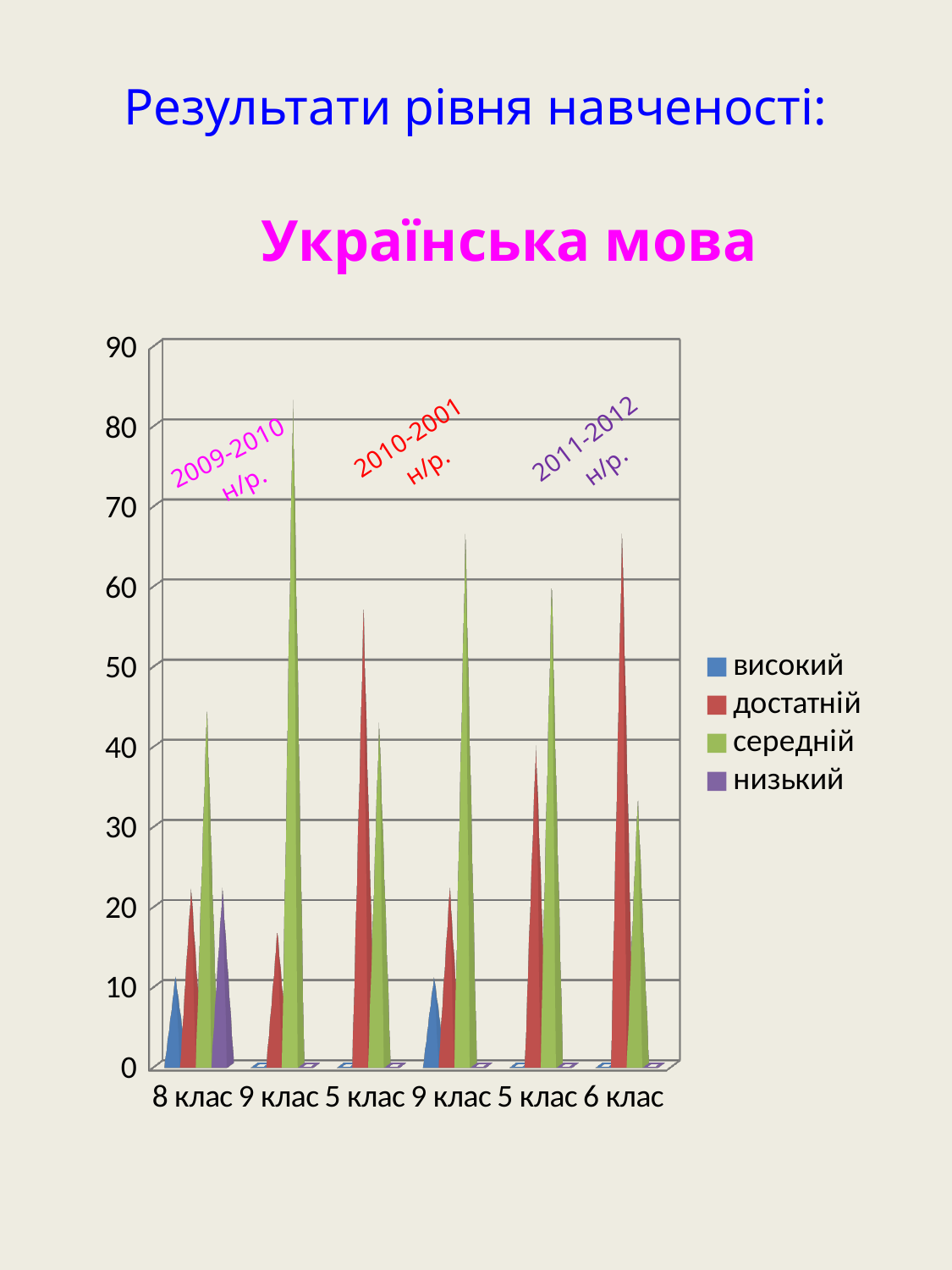
What kind of chart is shown on the slide? bar chart Is the достатній value for 6 клас greater or less than 50? greater Is the середній value for the first 9 клас (2009-2010 н/р.) greater or less than 70? greater Is the середній value for 8 клас greater or less than 50? less How many series does the legend list? 4 For 6 клас, which is larger: достатній or середній? достатній Which category has the tallest середній bar? 9 клас (the second category, 2009-2010 н/р.) For the first 5 клас (2010-2001 н/р.), which is larger: достатній or середній? достатній How many categories are shown along the x axis? 6 Which colour represents the series низький in the legend? purple